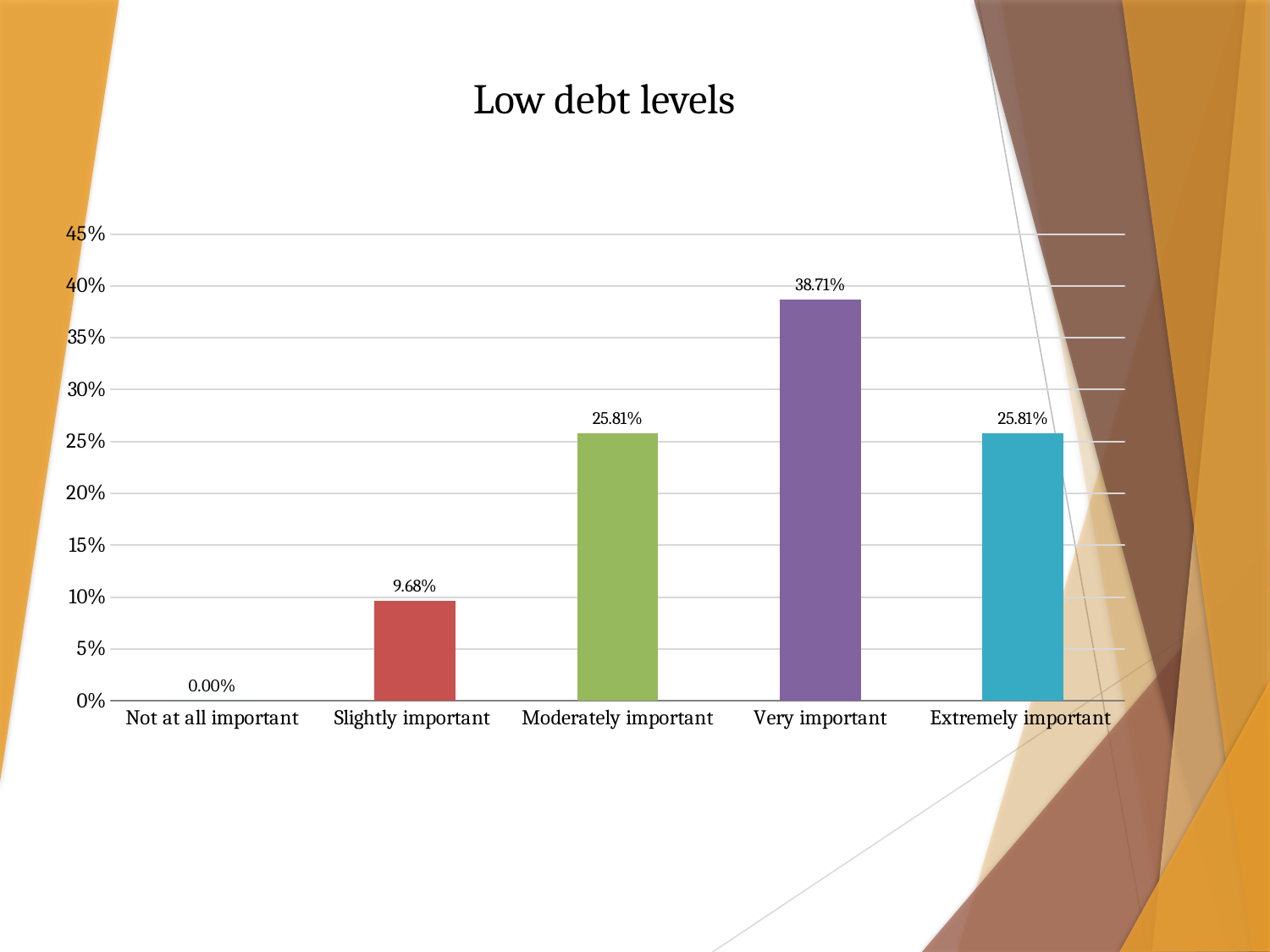
What is the value for Very important? 38.71% Which category has the highest value? Very important Which category has the lowest value? Not at all important What is the difference between the values for Moderately important and Slightly important? 16.13% What kind of chart is shown on the slide? Bar chart What is the value for Moderately important? 25.81% Which is larger, the value for Slightly important or the value for Moderately important? Moderately important What is the title of the chart? Low debt levels How many categories are shown on the x axis? 5 What is the value for Not at all important? 0.00% What is the value for Slightly important? 9.68% What is the difference between the values for Very important and Extremely important? 12.90%